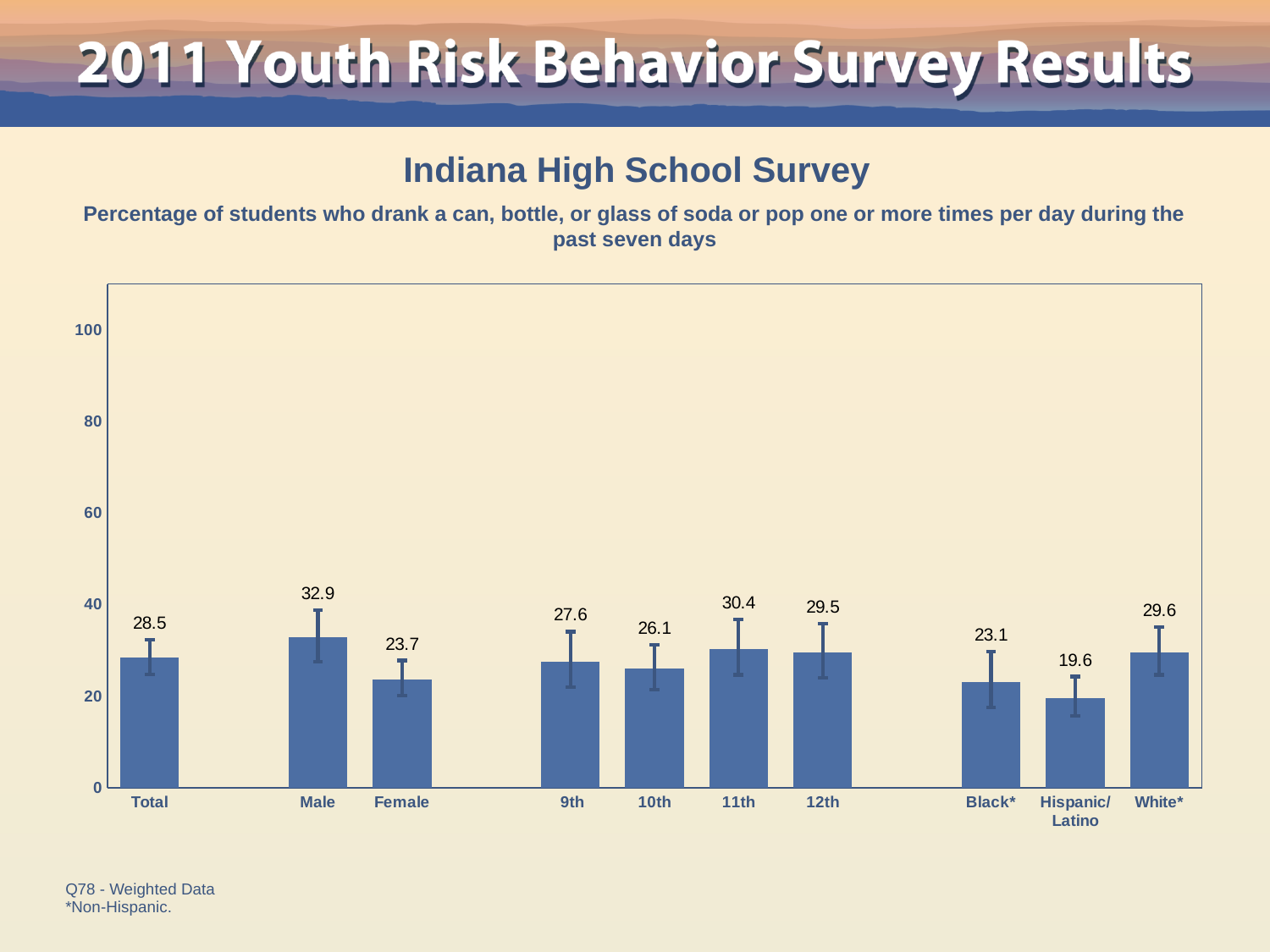
Which is larger, the value for 9th grade or the value for 10th grade? 9th What is the value for 11th grade? 30.4 What is the value for Male? 32.9 How many categories are shown on the x axis? 10 What is the difference between the Total value and the Black* value? 5.4 Is the value for White* greater or less than 40? less Which category has the lowest value? Hispanic/Latino What kind of chart is this? bar chart What is the title of the survey shown above the chart? Indiana High School Survey Which category has the highest value? Male What is the difference between the Male and Female values? 9.2 What is the value for Hispanic/Latino? 19.6